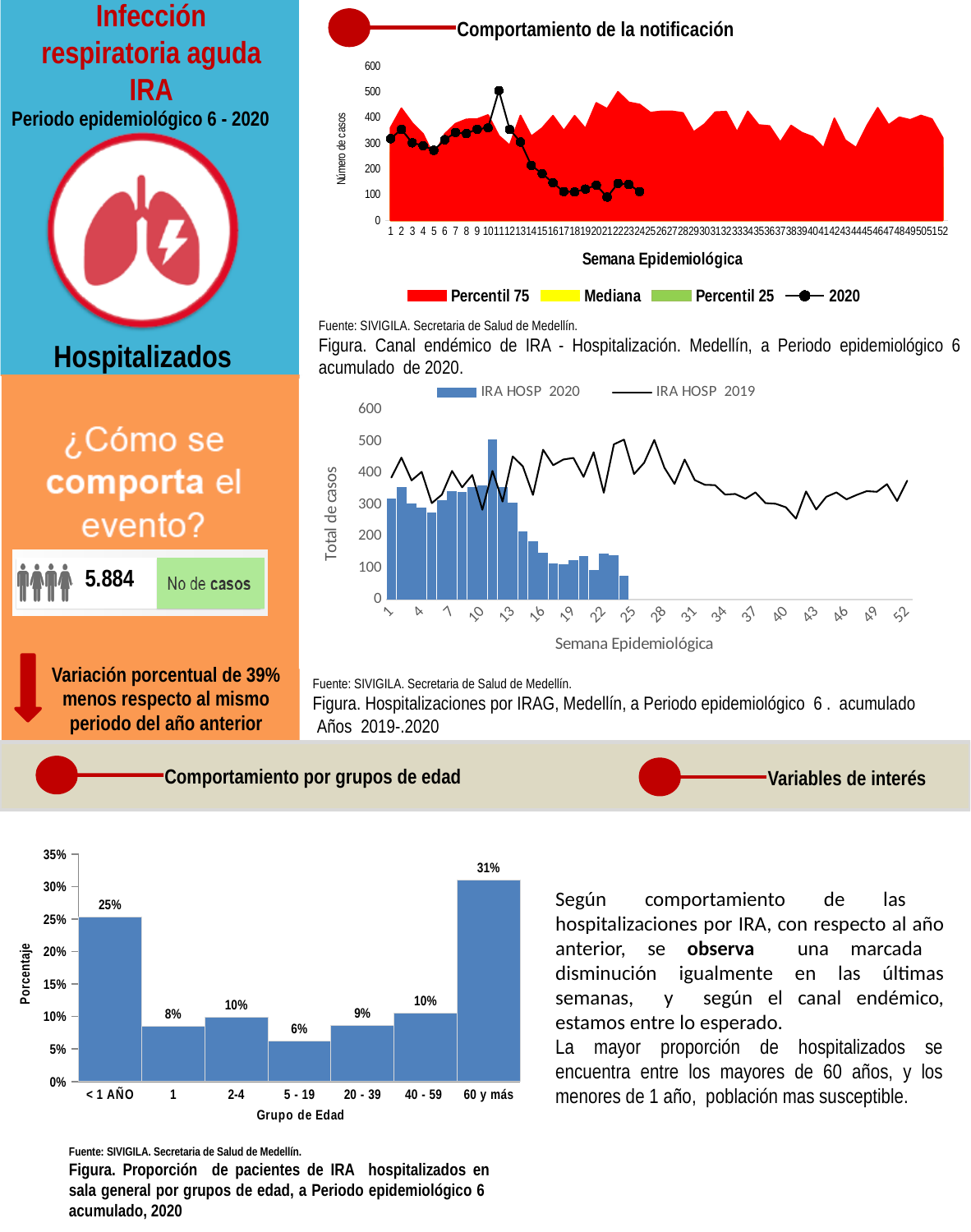
How many age groups are shown in the bottom-left chart of IRA hospitalized patients by age group? 7 In the bottom-left chart of IRA hospitalized patients by age group, which is larger, the value for '20 - 39' or the value for '1'? 20 - 39 In the bottom-left chart of IRA hospitalized patients by age group, which age group has the highest percentage? 60 y más In the bottom-left chart of IRA hospitalized patients by age group, what is the difference between the '60 y más' and '< 1 AÑO' percentages? 6% In the bottom-left chart of IRA hospitalized patients by age group, what percentage is shown for the '< 1 AÑO' group? 25% In the bottom-left chart of IRA hospitalized patients by age group, which age group has the lowest percentage? 5 - 19 In the middle-right chart of hospitalizations by IRAG, is the IRA HOSP 2020 value for week 24 greater or less than 100? less How many series does the legend list in the top-right chart 'Canal endémico de IRA - Hospitalización'? 4 What kind of chart is the bottom-left chart of IRA hospitalized patients by age group? Bar chart How many series does the legend list in the middle-right chart of hospitalizations by IRAG, years 2019-2020? 2 In the bottom-left chart of IRA hospitalized patients by age group, what percentage is shown for the '5 - 19' group? 6% In the bottom-left chart of IRA hospitalized patients by age group, what percentage is shown for the '60 y más' group? 31%